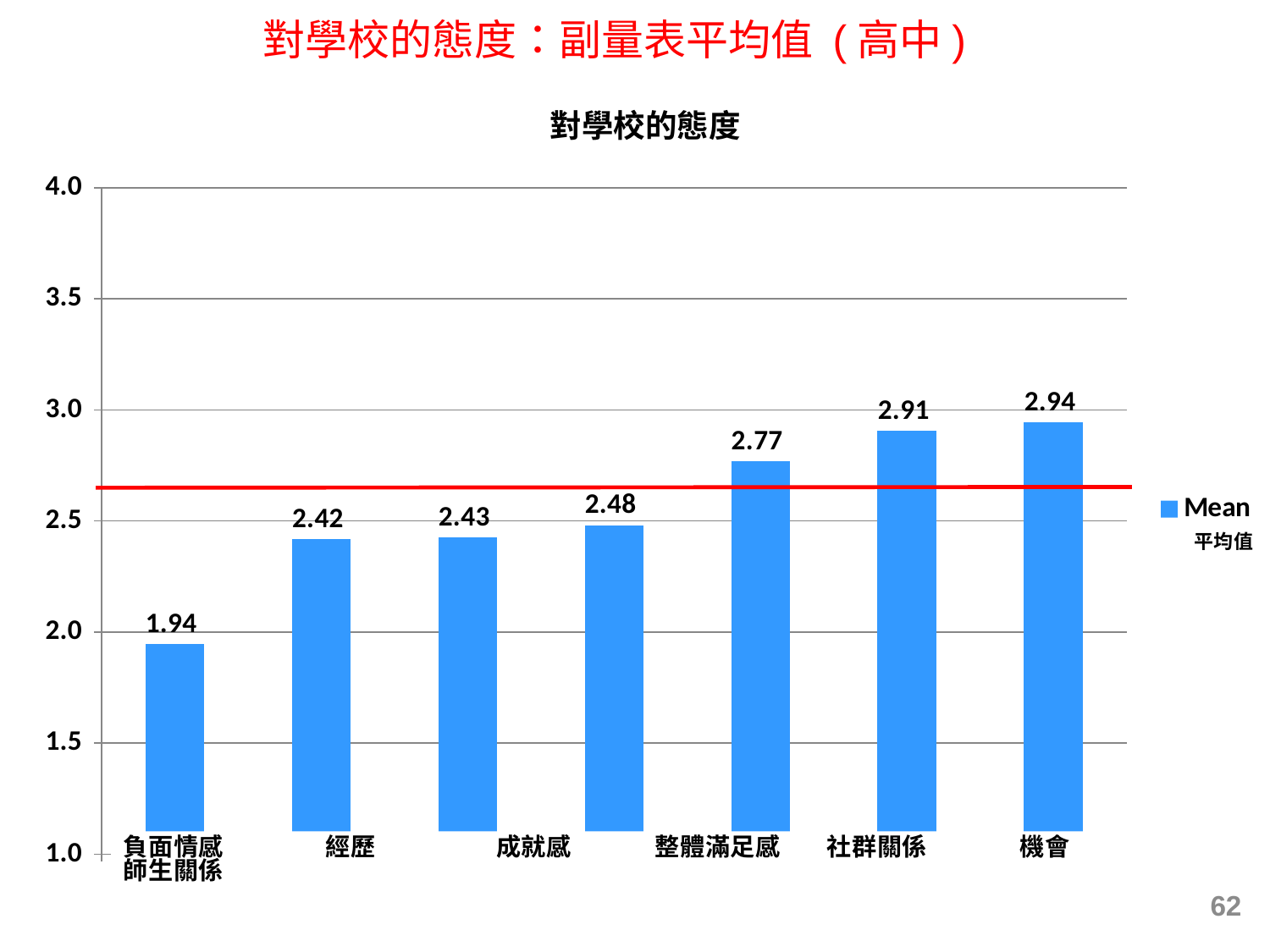
Which category has the lowest mean value? 負面情感師生關係 What is the mean value for 機會? 2.94 Which category has the highest mean value? 機會 What is the title of the chart? 對學校的態度 Which has a larger mean value, 整體滿足感 or 成就感? 整體滿足感 What kind of chart is shown on the slide? bar chart Is the mean value for 經歷 greater or less than 2.5? less What is the mean value for 負面情感師生關係? 1.94 What is the difference between the mean values for 機會 and 負面情感師生關係? 1.00